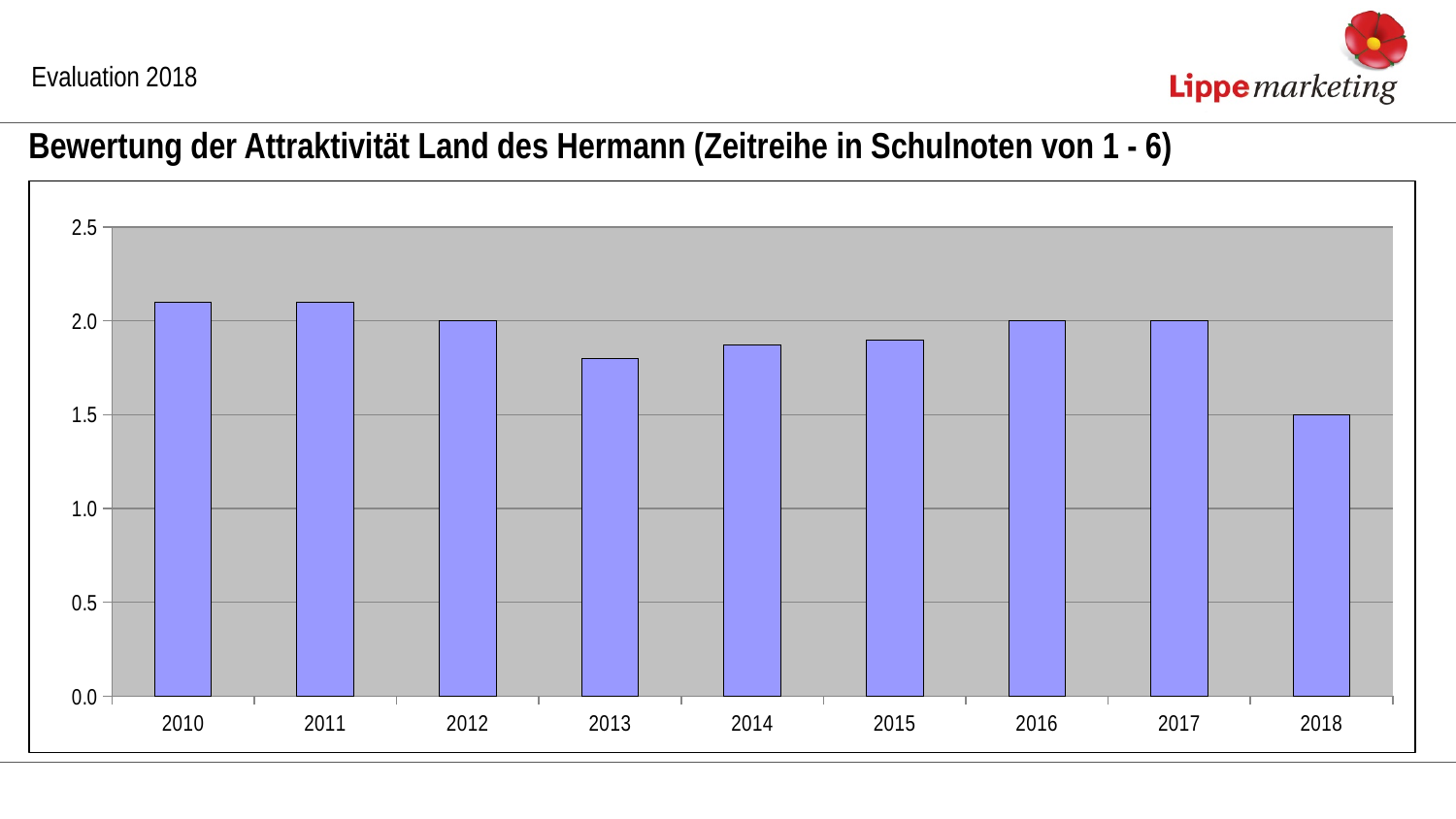
What kind of chart is shown on the slide? bar chart Is the value for 2013 greater or less than 2.0? less Which is larger, the value for 2013 or the value for 2016? 2016 What is the value for 2018? 1.5 What is the title of the chart on the slide? Bewertung der Attraktivität Land des Hermann (Zeitreihe in Schulnoten von 1 - 6) How many years are shown on the x axis of the chart? 9 Is the value for 2018 greater or less than 1.0? greater Which is larger, the value for 2010 or the value for 2018? 2010 Which year has the lowest value in the chart? 2018 What is the value for 2017? 2.0 What is the value for 2012? 2.0 Is the value for 2010 greater or less than 2.0? greater